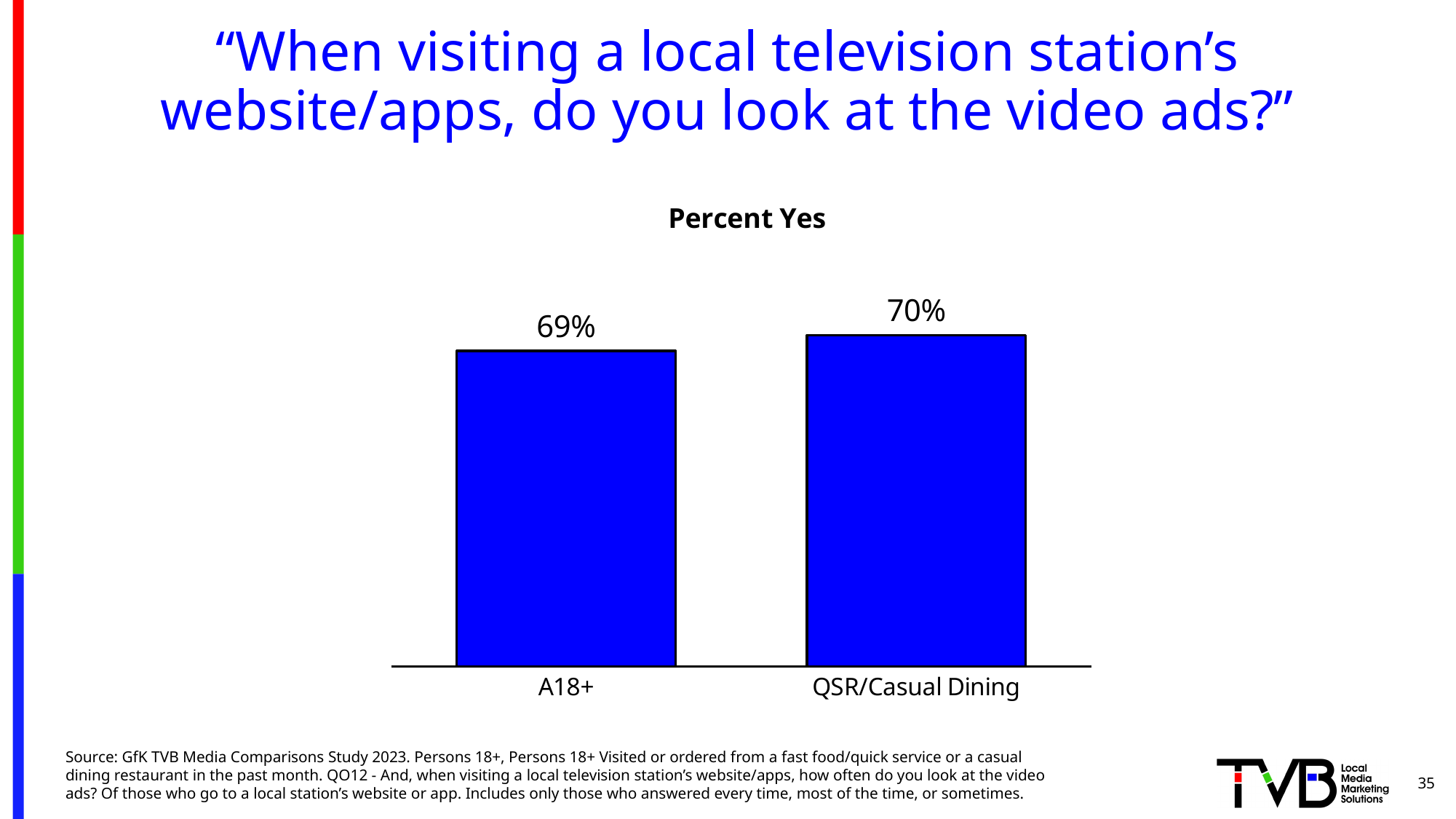
What kind of chart is shown on the slide? bar chart What is the Percent Yes value for QSR/Casual Dining? 70% What is the Percent Yes value for A18+? 69% Which category has the lower Percent Yes value? A18+ Which category has the higher Percent Yes value? QSR/Casual Dining What colour are the bars in the chart? blue How many categories are shown in the chart? 2 What is the difference in percentage points between QSR/Casual Dining and A18+? 1 percentage point Is the value for QSR/Casual Dining larger or smaller than the value for A18+? larger What is the title of the chart? Percent Yes